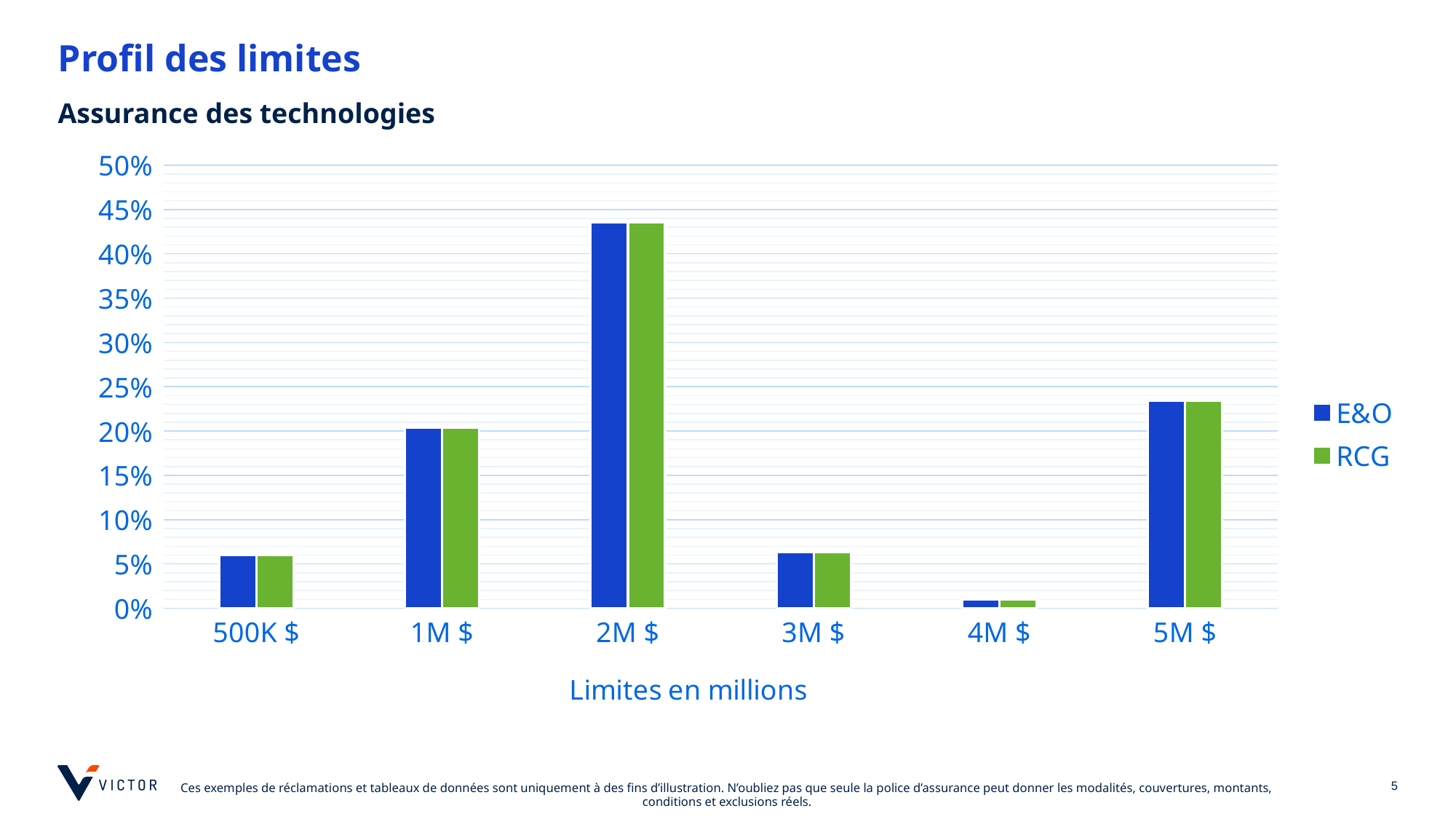
Which limit category has the lowest share for RCG? 4M $ Which limit category has the highest share for E&O? 2M $ Is the RCG value for 4M $ greater or less than 5%? less What are the two series named in the legend? E&O and RCG How many series does the legend list? 2 Is the E&O value for 5M $ greater or less than 20%? greater Is the E&O value for 2M $ greater or less than 40%? greater What is the title of the x axis? Limites en millions What kind of chart is shown on the slide? bar chart How many limit categories are shown on the x axis? 6 Which is larger for E&O: the value for 5M $ or the value for 1M $? 5M $